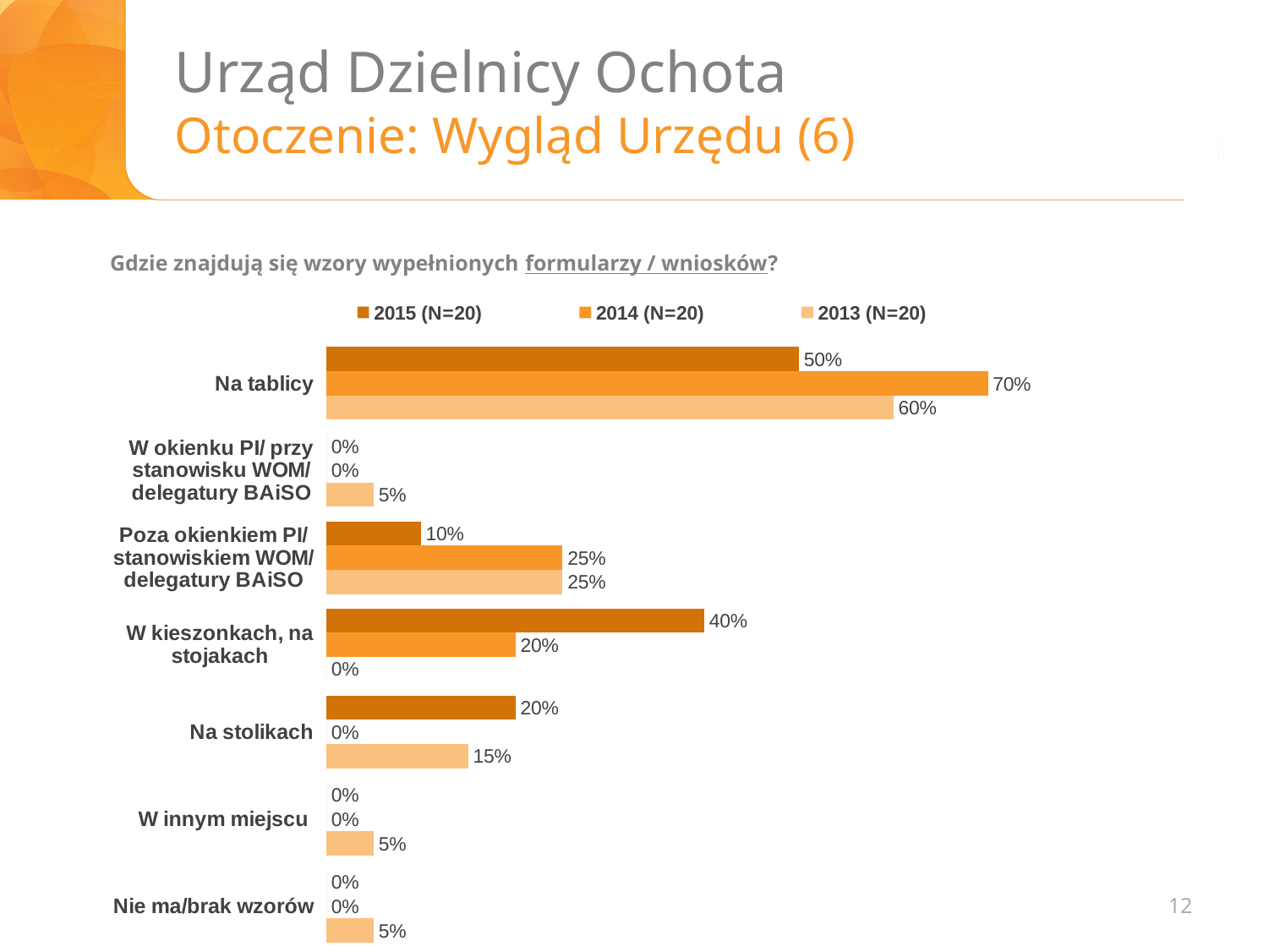
What is the value for "Na tablicy" in the 2014 (N=20) series? 70% What is the value for "Na stolikach" in the 2013 (N=20) series? 15% How many categories are shown on the chart? 7 What is the difference between the 2015 and 2014 values for "W kieszonkach, na stojakach"? 20% Which is larger for "Poza okienkiem PI/ stanowiskiem WOM/ delegatury BAiSO": the 2015 value or the 2014 value? 2014 What is the difference between the 2014 and 2015 values for "Na tablicy"? 20% What is the value for "W kieszonkach, na stojakach" in the 2015 (N=20) series? 40% How many series does the legend list? 3 Which category has the highest value in the 2015 (N=20) series? Na tablicy What is the value for "W kieszonkach, na stojakach" in the 2013 (N=20) series? 0% What kind of chart is shown on the slide? Bar chart What question is the chart about, as stated above it? Gdzie znajdują się wzory wypełnionych formularzy / wniosków?